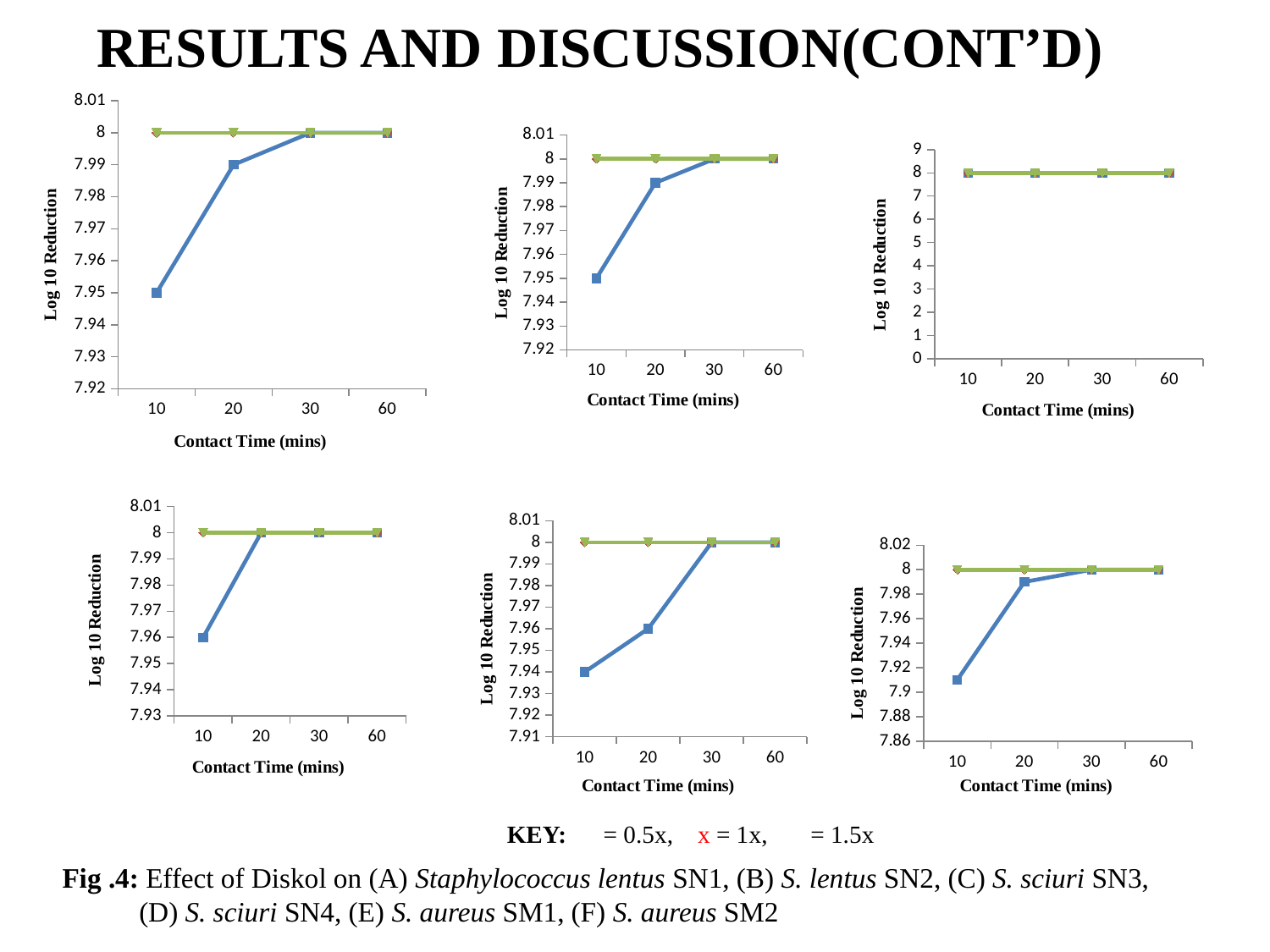
In the top-left chart, what is the difference between the blue line's values at 20 mins and 10 mins? 0.04 In the bottom-middle chart, which is larger for the blue line: the value at 10 mins or at 30 mins? 30 mins In the top-left chart, what is the Log 10 Reduction of the blue line at 20 mins? 7.99 What kind of chart is the top-left chart? line chart In the bottom-left chart, what is the Log 10 Reduction of the blue line at 10 mins? 7.96 What is the x-axis title of the top-right chart? Contact Time (mins) In the top-middle chart, what is the Log 10 Reduction of the blue line at 10 mins? 7.95 In the top-left chart, what is the Log 10 Reduction of the blue line at 10 mins? 7.95 How many contact-time points are plotted along the x axis of the top-left chart? 4 In the bottom-right chart, is the blue line's value at 10 mins greater or less than 7.92? less In the top-left chart, does the blue line rise or fall as contact time increases? rise In the bottom-middle chart, what is the Log 10 Reduction of the blue line at 20 mins? 7.96